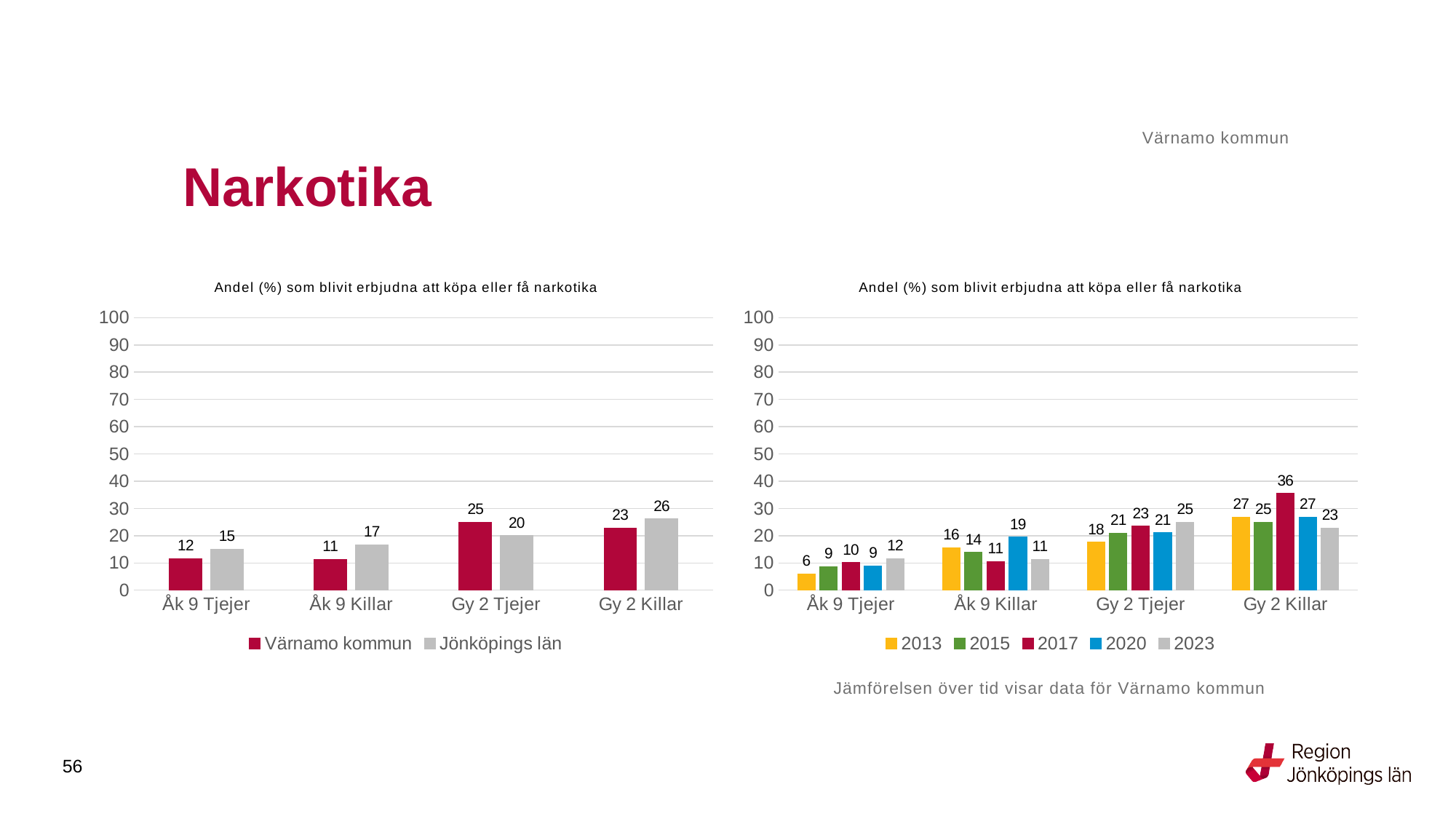
What kind of chart is the right chart? Bar chart In the left chart, which category has the highest value for Jönköpings län? Gy 2 Killar In the right chart, which year has the lowest value for Åk 9 Tjejer? 2013 How many series does the legend of the left chart list? 2 In the right chart, what is the value for 2020 for Åk 9 Killar? 19 In the left chart, what is the difference between Jönköpings län and Värnamo kommun for Åk 9 Killar? 6 In the left chart, which is larger for Gy 2 Tjejer: Värnamo kommun or Jönköpings län? Värnamo kommun In the left chart, what is the value for Jönköpings län for Åk 9 Killar? 17 How many series does the legend of the right chart list? 5 In the right chart, what is the difference between the 2017 and 2023 values for Gy 2 Killar? 13 In the left chart, what is the value for Värnamo kommun for Gy 2 Tjejer? 25 In the right chart, what is the value for 2017 for Gy 2 Killar? 36